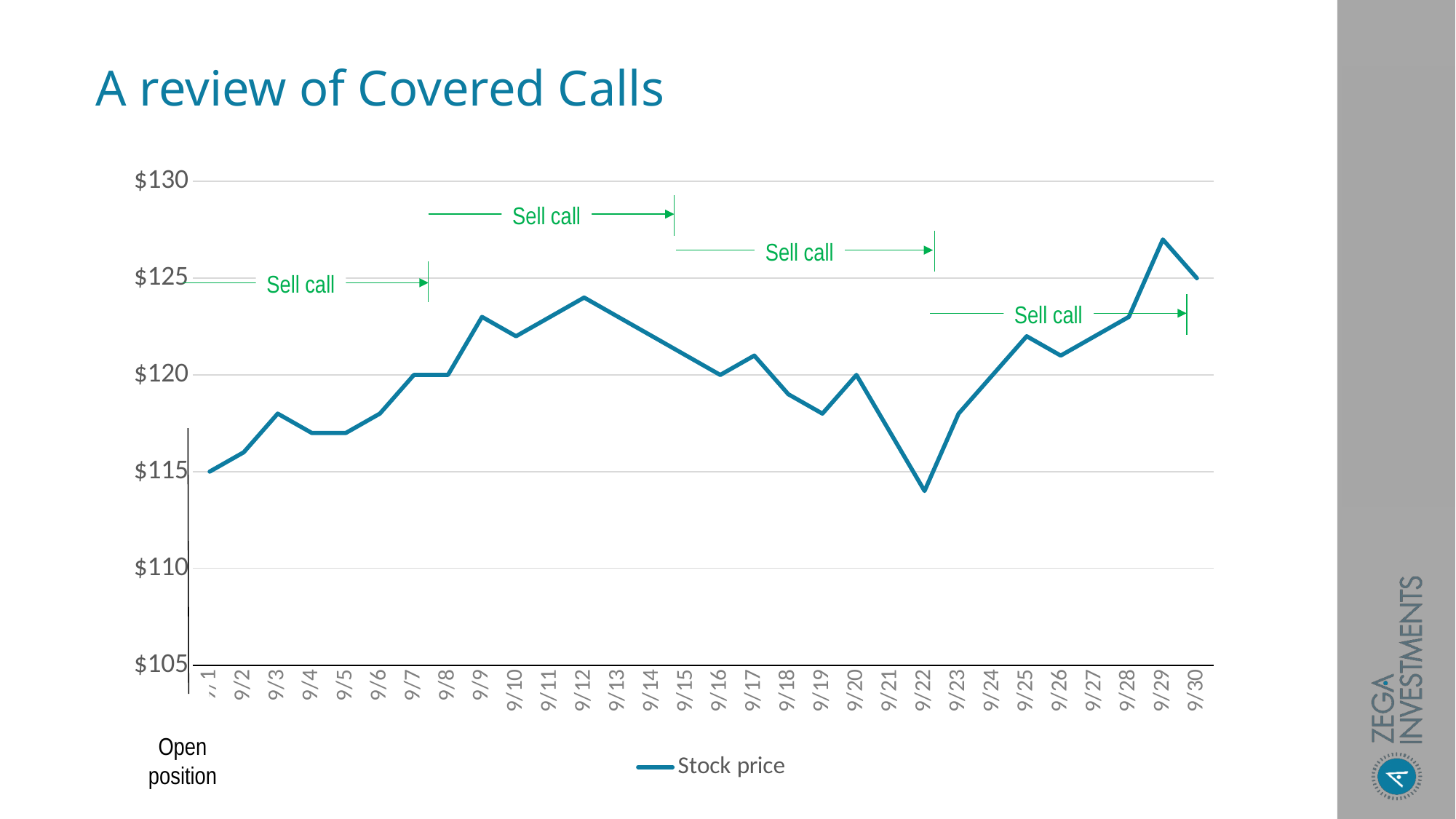
How many series does the legend list? 1 What kind of chart is shown on the slide? line chart What is the stock price on 9/16? $120 Is the stock price on 9/29 greater or less than $125? greater What is the stock price on 9/30? $125 Is the stock price on 9/22 greater or less than $115? less How many dates are plotted along the x axis? 30 On which date is the stock price lowest? 9/22 What is the name of the series shown in the legend? Stock price What is the stock price on 9/1? $115 Does the stock price rise or fall from 9/12 to 9/22? fall On which date is the stock price highest? 9/29